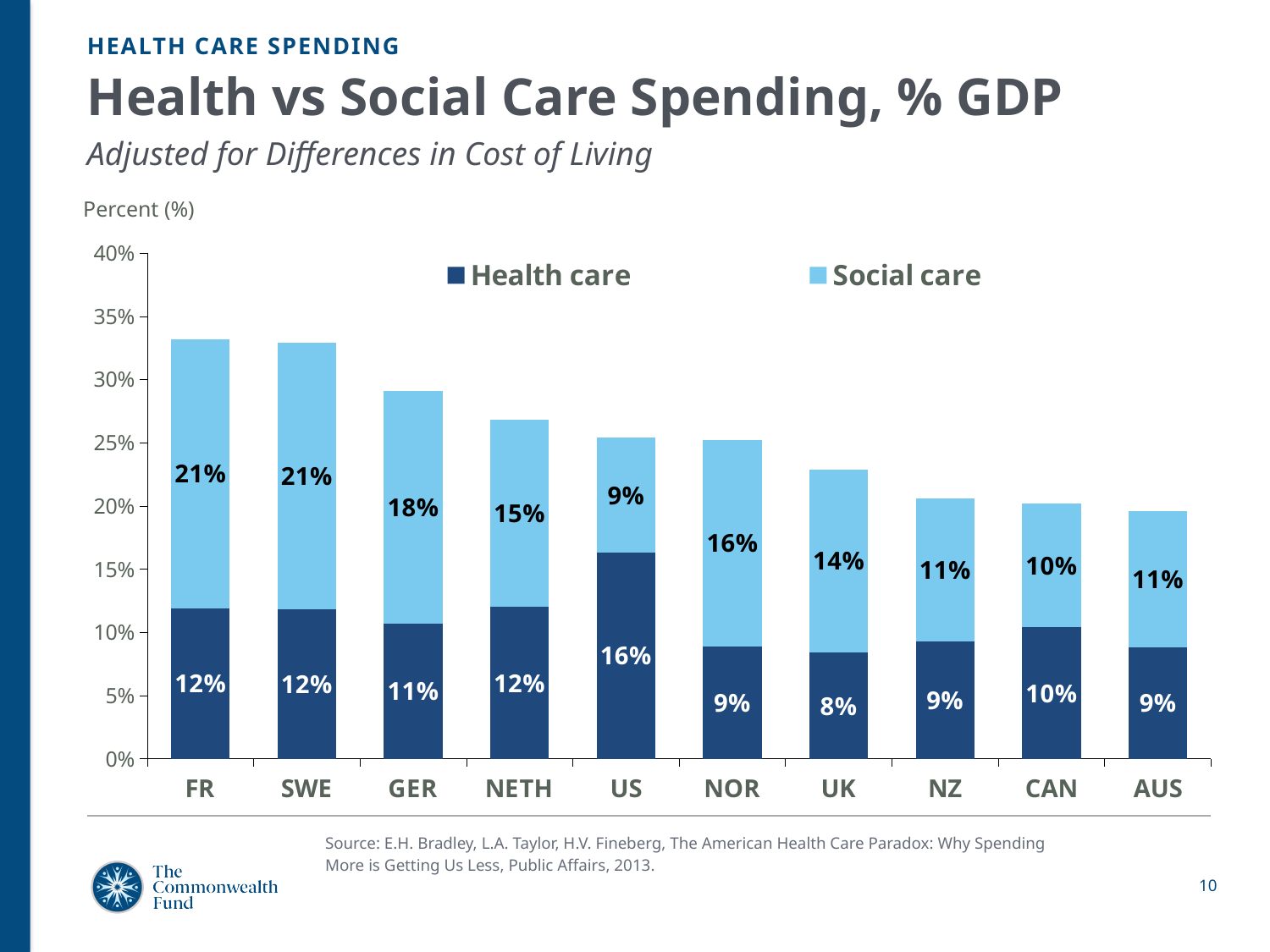
Which is larger, the Social care value for the UK or the Social care value for NZ? UK How many series does the legend list? 2 What is the Social care value for GER? 18% What is the difference between Social care and Health care spending for NOR? 7 percentage points Which country has the lowest Social care spending? US Which country has the lowest Health care spending? UK How many countries are shown on the x axis? 10 Do the total bar heights rise or fall from left to right across the x axis? Fall What kind of chart is shown on the slide? Stacked bar chart What is the total of the stacked bar for GER? 29% Which country has the highest Health care spending? US What is the Health care value for the US? 16%